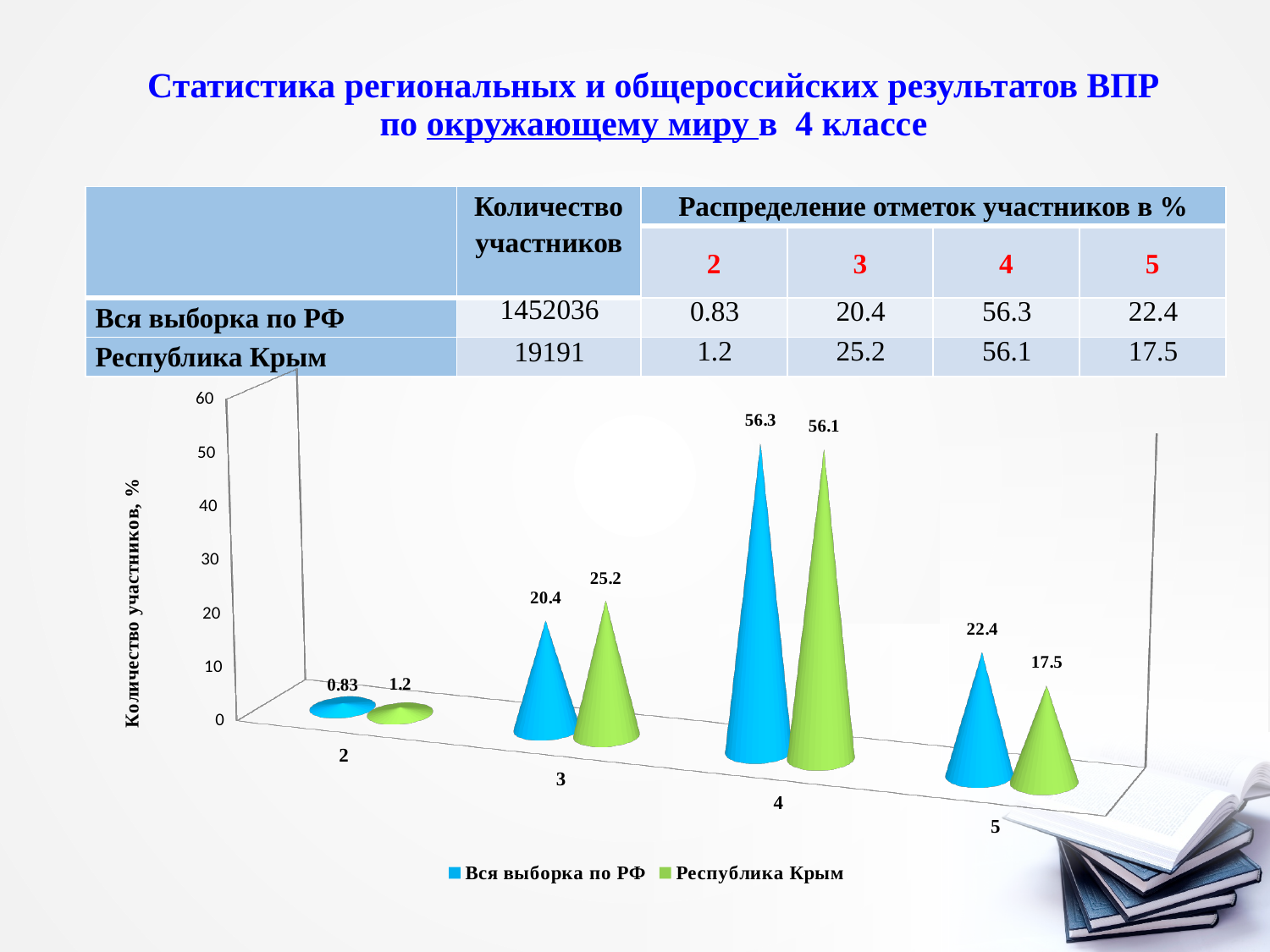
What is the difference between the 'Республика Крым' and 'Вся выборка по РФ' values for grade 3? 4.8 How many series does the chart legend list? 2 What is the label of the vertical axis of the chart? Количество участников, % Which grade category has the lowest value for 'Республика Крым'? 2 What is the difference between the 'Вся выборка по РФ' and 'Республика Крым' values for grade 5? 4.9 For grade 5, which series has the larger value: 'Вся выборка по РФ' or 'Республика Крым'? Вся выборка по РФ What is the value for grade 4 in the 'Вся выборка по РФ' series? 56.3 What is the value for grade 5 in the 'Республика Крым' series? 17.5 How many grade categories are shown on the x axis of the chart? 4 What is the value for grade 2 in the 'Вся выборка по РФ' series? 0.83 What is the value for grade 3 in the 'Республика Крым' series? 25.2 Which grade category has the highest value for 'Вся выборка по РФ'? 4